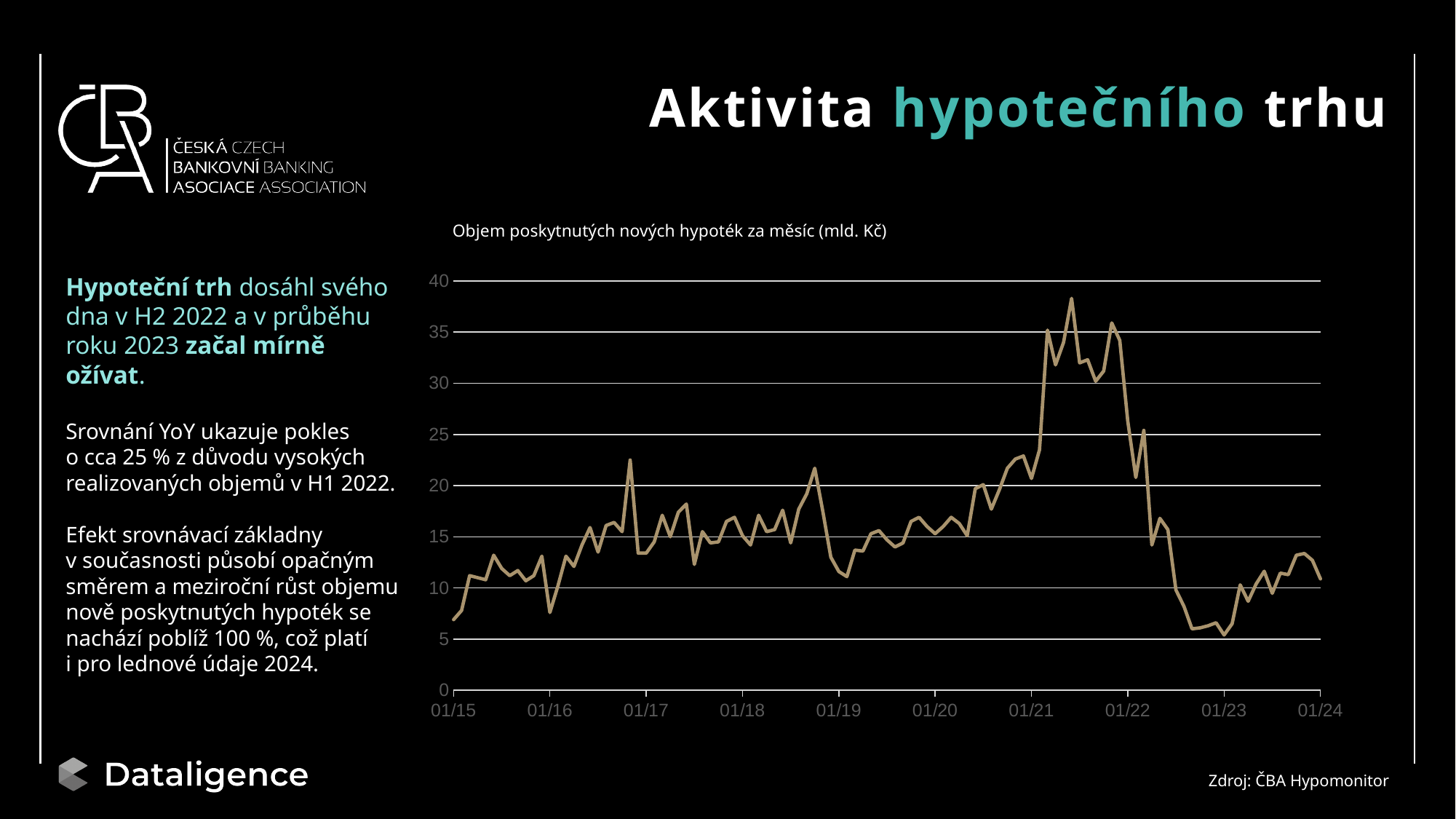
Is the value at 01/15 greater or less than 10? less What source is cited for the chart? ČBA Hypomonitor Is the value at 01/21 greater or less than 20? greater Is the value at 01/23 greater or less than 10? less How many year labels are shown on the x axis of the chart? 10 Between which two x-axis labels does the peak of the line occur? between 01/21 and 01/22 What is the title of the chart? Objem poskytnutých nových hypoték za měsíc (mld. Kč) Does the line rise or fall between 01/22 and 01/23? fall How many lines are plotted on the chart? 1 What kind of chart is shown on the slide? line chart